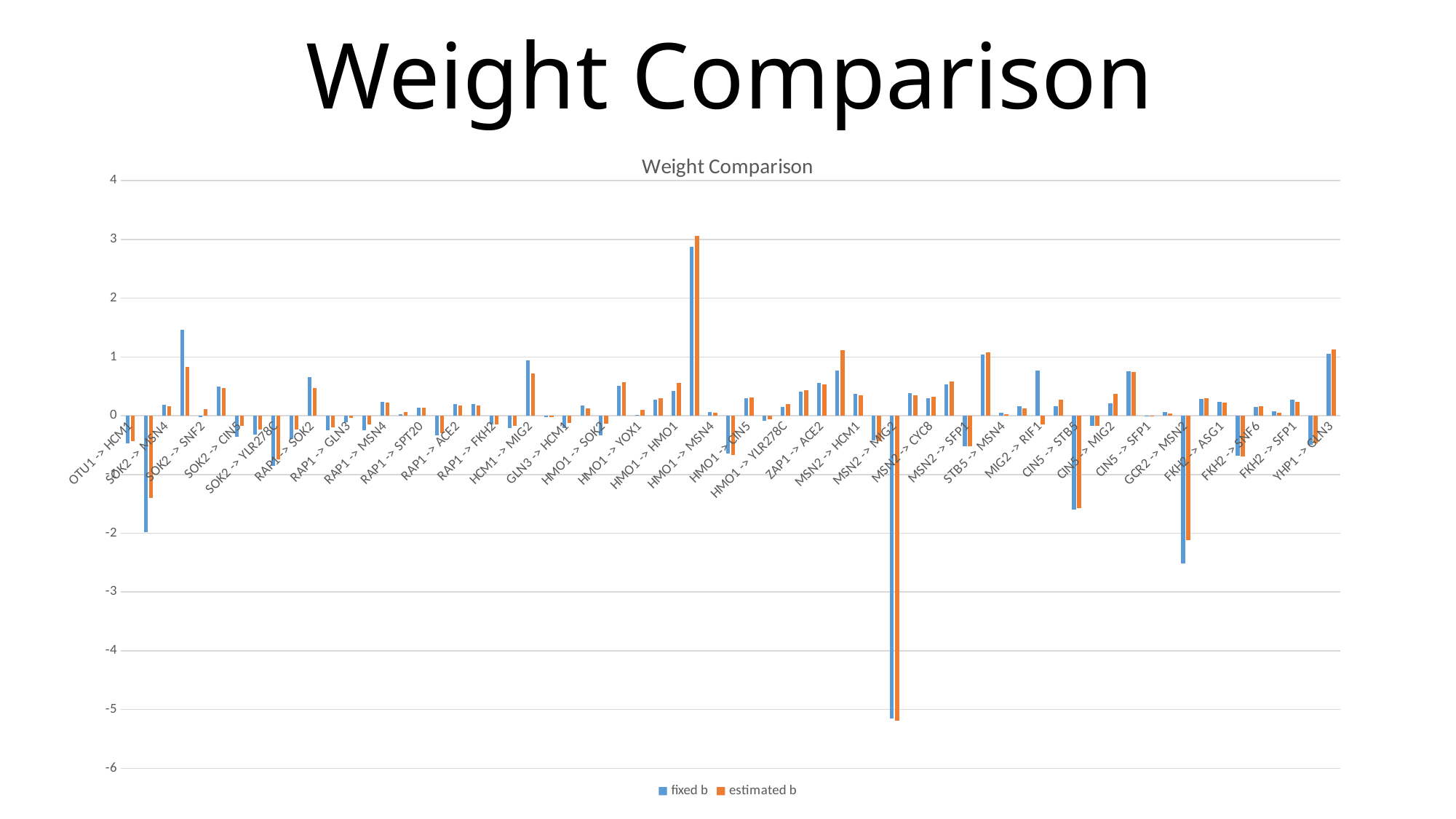
What are the two series named in the legend? fixed b and estimated b What is the minimum value shown on the vertical axis? -6 Is the lowest plotted value on the chart greater or less than -4? less What is the title of the chart? Weight Comparison What kind of chart is shown on the slide? bar chart How many series does the legend list? 2 Is the highest plotted value on the chart greater or less than 2? greater